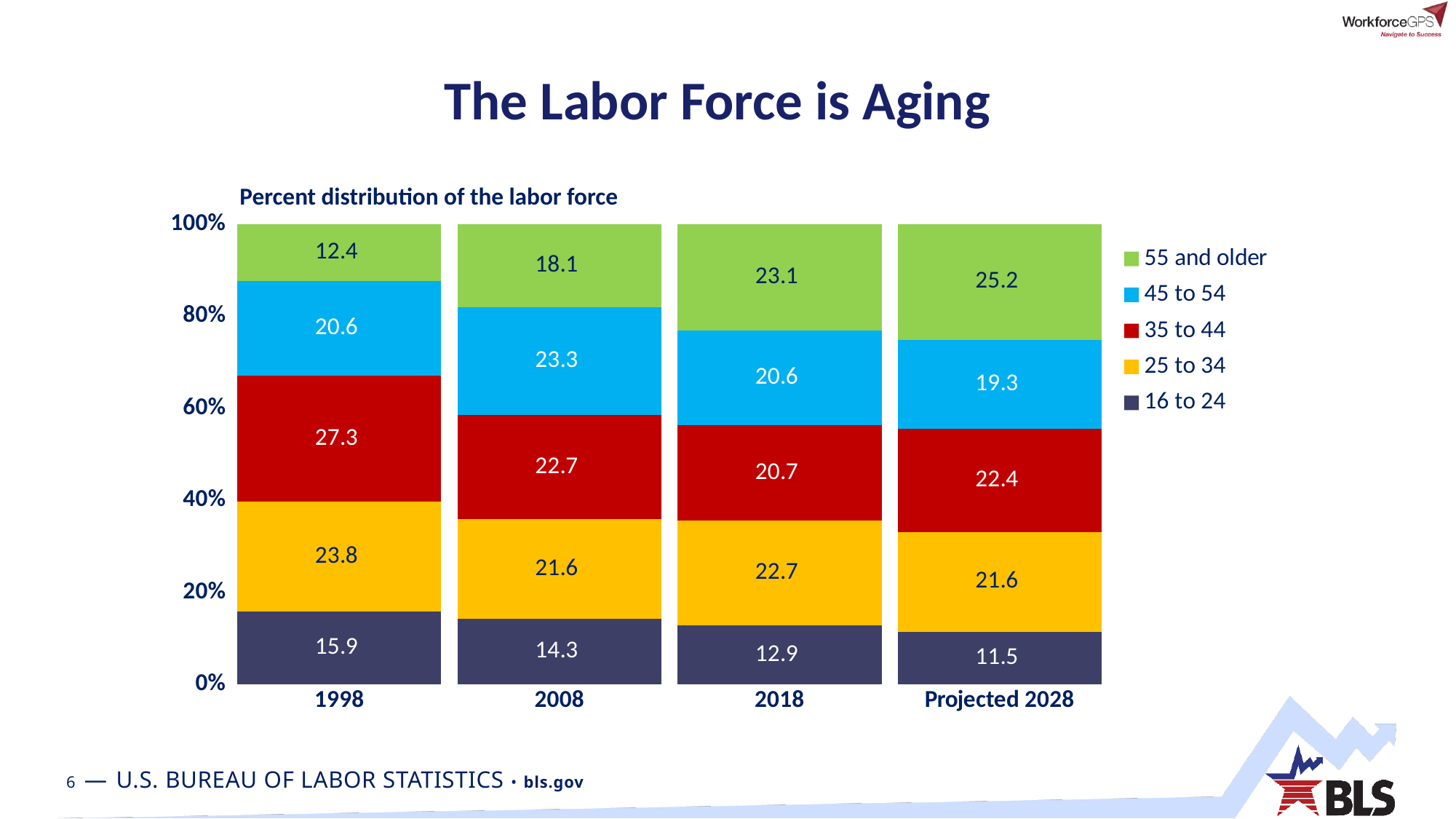
What is the value for the 45 to 54 group in 2008? 23.3 What kind of chart is shown on the slide? Stacked bar chart In which year is the 55 and older share the highest? Projected 2028 How many bars (years) are shown on the chart? 4 How many series does the legend list? 5 Does the 16 to 24 share rise or fall from 1998 to Projected 2028? Fall What is the value for the 16 to 24 group in Projected 2028? 11.5 What is the value for the 55 and older group in 2018? 23.1 What is the difference between the 55 and older share in Projected 2028 and in 1998? 12.8 In which year is the 16 to 24 share the lowest? Projected 2028 What is the subtitle printed above the chart? Percent distribution of the labor force Which is larger, the 35 to 44 share in 1998 or in 2008? 1998